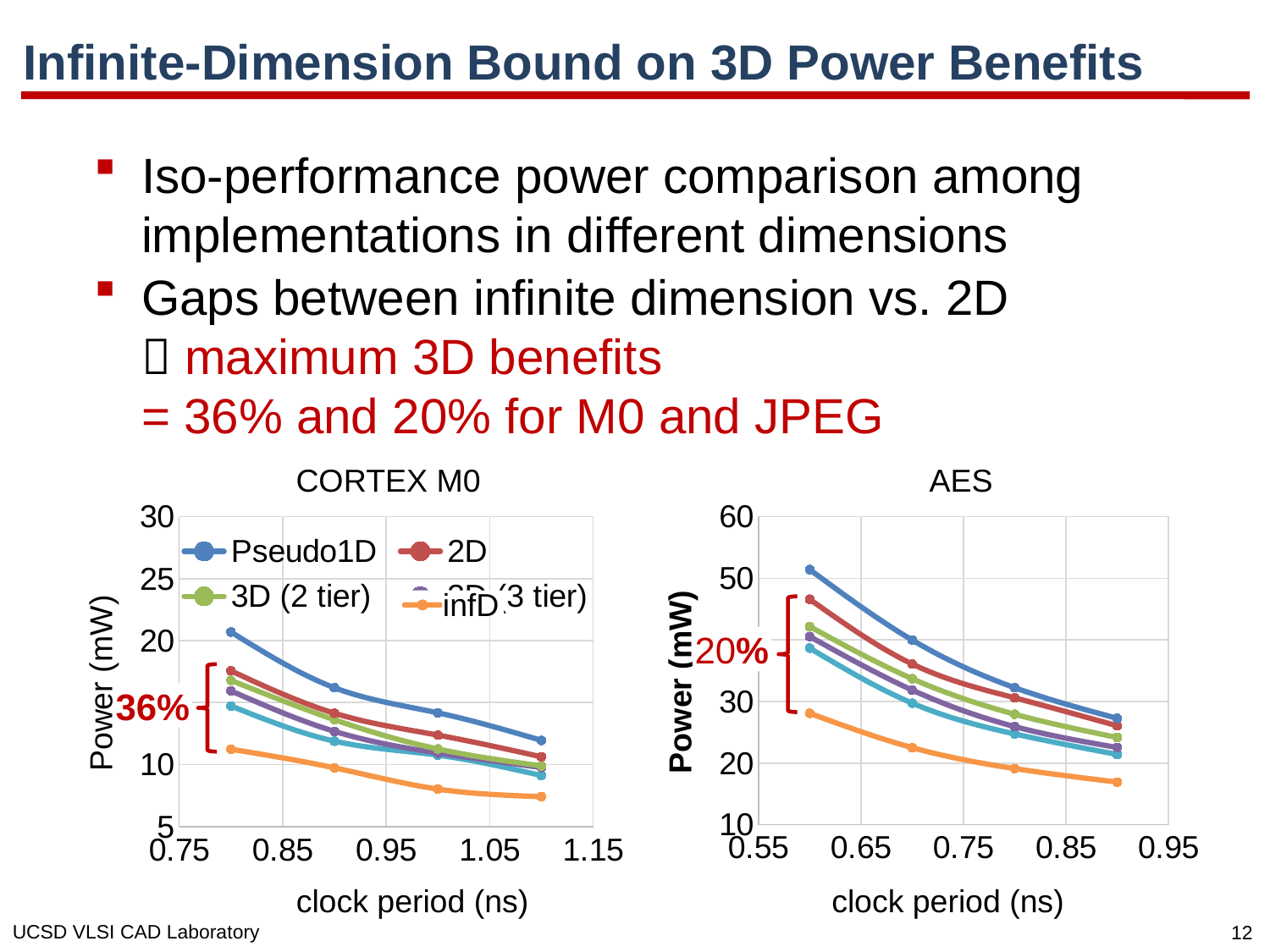
In the CORTEX M0 chart, how many data points does each series have? 4 In the CORTEX M0 chart, is the infD power at a clock period of 1.1 ns greater or less than 10 mW? less In the AES chart, how does power change as the clock period increases along the x axis? falls What kind of chart is the CORTEX M0 chart? line chart In the AES chart, how many data points does each series have? 4 What is the x-axis label of the AES chart? clock period (ns) In the CORTEX M0 chart, which series has the lowest power across the clock periods? infD In the CORTEX M0 chart, is the Pseudo1D power at a clock period of 0.8 ns greater or less than 15 mW? greater In the CORTEX M0 chart, which series has the highest power across the clock periods? Pseudo1D